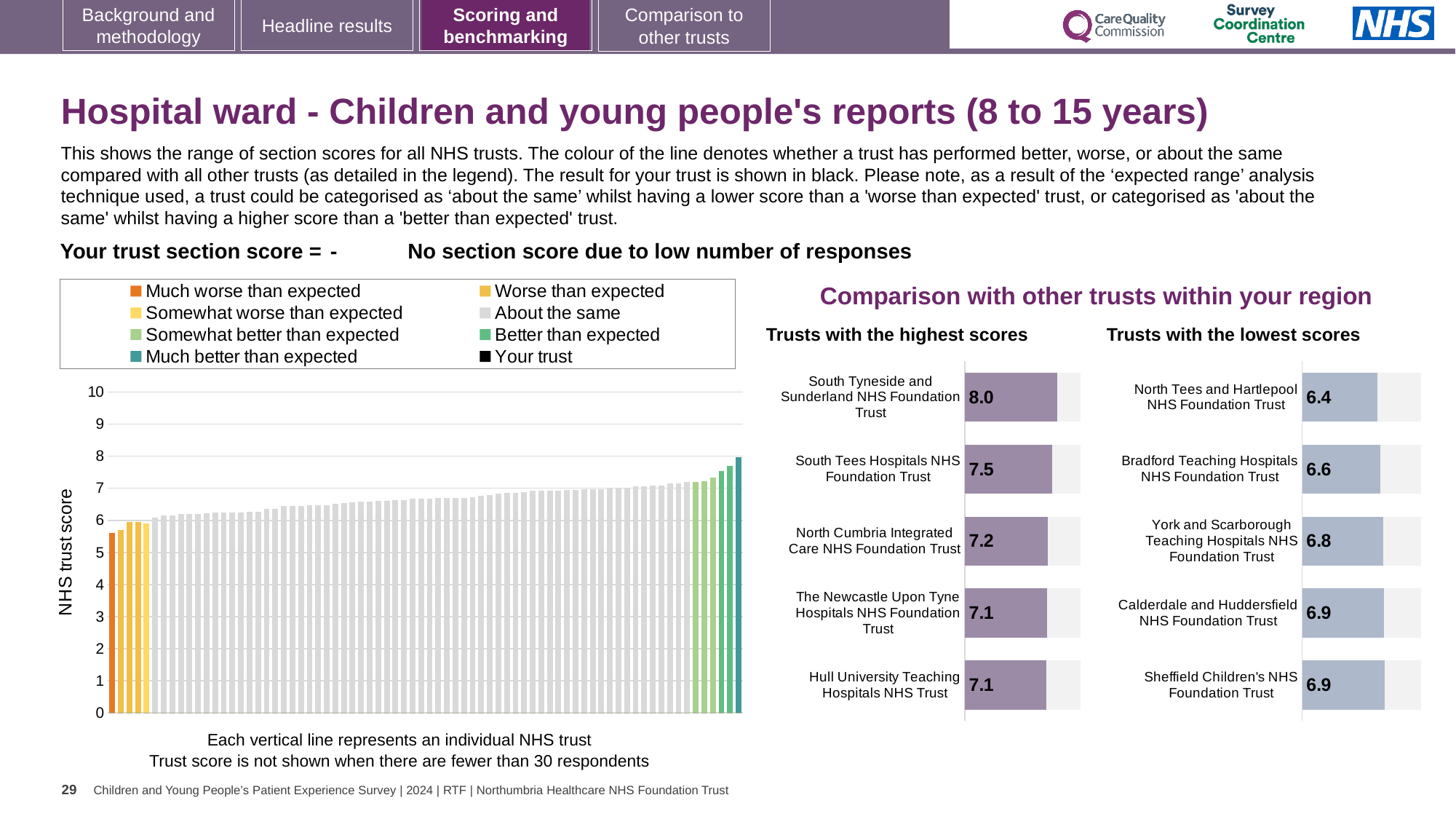
In the large 'NHS trust score' chart on the left, is the value of the tallest bar greater or less than 7? greater In the 'Trusts with the lowest scores' chart, which trust has the lowest score? North Tees and Hartlepool NHS Foundation Trust In the 'Trusts with the highest scores' chart, what is the difference between the scores of South Tyneside and Sunderland NHS Foundation Trust and South Tees Hospitals NHS Foundation Trust? 0.5 In the 'Trusts with the highest scores' chart, which has the higher score: North Cumbria Integrated Care NHS Foundation Trust or Hull University Teaching Hospitals NHS Trust? North Cumbria Integrated Care NHS Foundation Trust In the 'Trusts with the lowest scores' chart, what is the difference between the scores of York and Scarborough Teaching Hospitals NHS Foundation Trust and North Tees and Hartlepool NHS Foundation Trust? 0.4 In the 'Trusts with the highest scores' chart, which trust has the highest score? South Tyneside and Sunderland NHS Foundation Trust How many entries does the legend above the large 'NHS trust score' chart list? 8 In the 'Trusts with the lowest scores' chart, what is the score for Bradford Teaching Hospitals NHS Foundation Trust? 6.6 In the large 'NHS trust score' chart on the left, do the bar heights rise or fall from left to right? rise How many trusts are shown in the 'Trusts with the highest scores' chart? 5 In the 'Trusts with the highest scores' chart, what is the score for South Tyneside and Sunderland NHS Foundation Trust? 8.0 What kind of chart is the large 'NHS trust score' chart on the left of the slide? bar chart